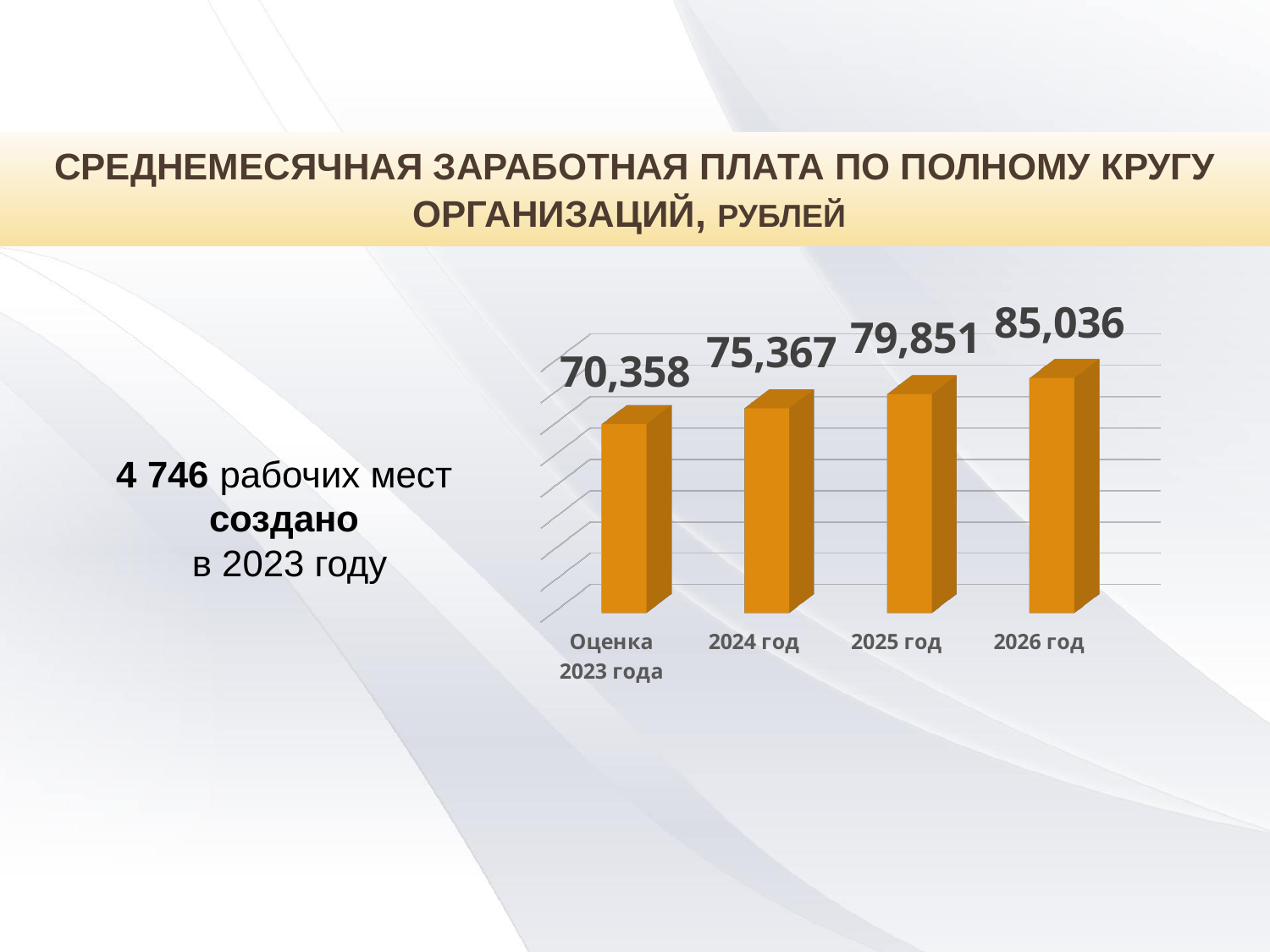
What is the difference between the values for 2026 год and 2025 год? 5,185 What is the value for 2024 год? 75,367 What is the value for 2025 год? 79,851 Which category has the lowest value? Оценка 2023 года What is the value for Оценка 2023 года? 70,358 How many categories are shown in the chart? 4 Which is larger, the value for 2025 год or the value for 2024 год? 2025 год Do the values rise or fall from Оценка 2023 года to 2026 год? rise What is the difference between the values for 2024 год and Оценка 2023 года? 5,009 What is the value for 2026 год? 85,036 Which category has the highest value? 2026 год What kind of chart is shown on the slide? bar chart